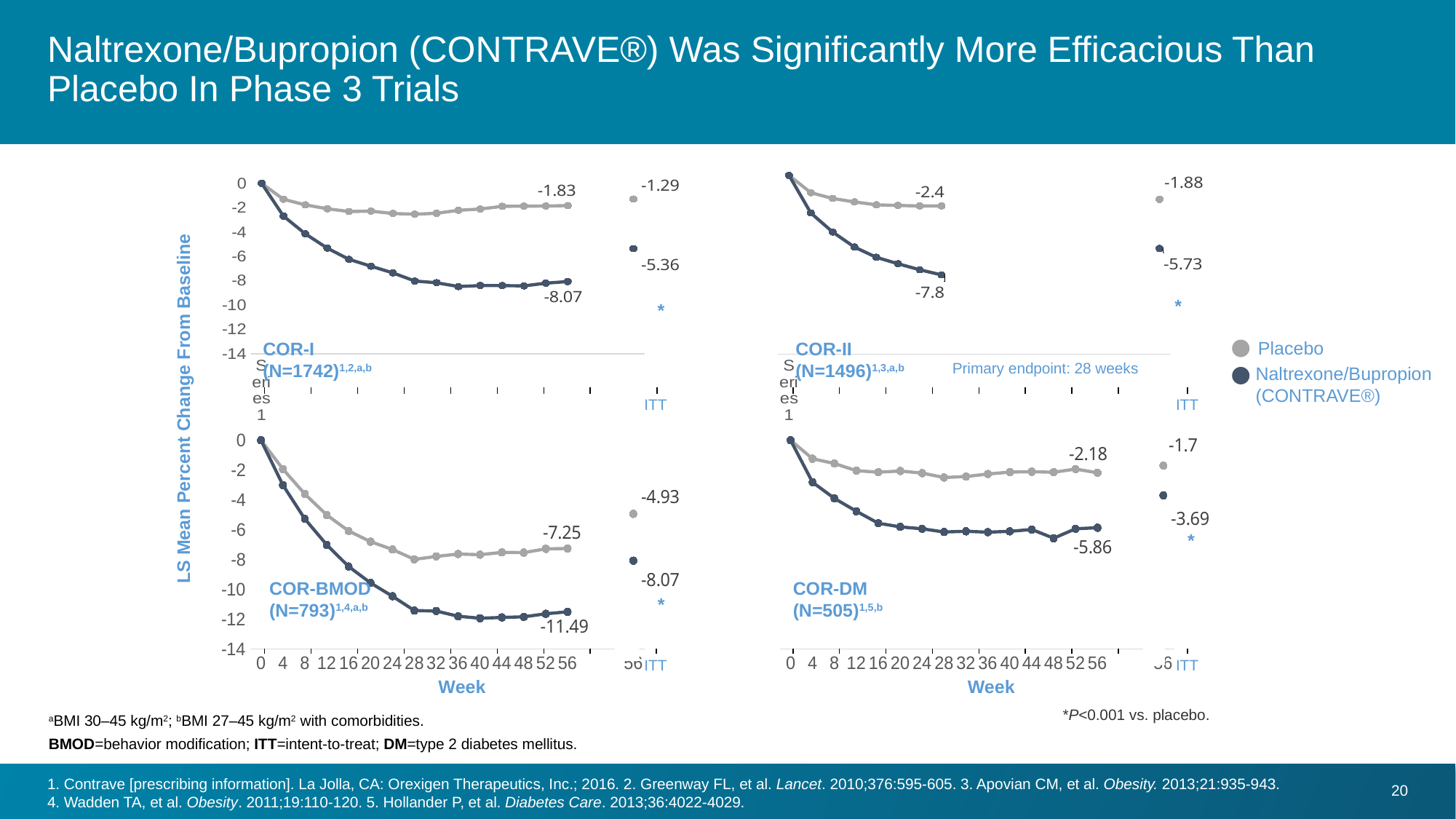
In the COR-I chart, does the Naltrexone/Bupropion (CONTRAVE) line rise or fall from week 0 to week 28? Fall How many series does the legend on the slide list? 2 In the COR-BMOD chart, what is the ITT value labeled for the Placebo group? -4.93 In the COR-I chart, what is the week 56 value labeled for the Naltrexone/Bupropion (CONTRAVE) line? -8.07 What kind of chart is used to show the COR-II results? Line chart In the COR-BMOD chart, what is the week 56 value labeled for the Placebo line? -7.25 In the COR-I chart, what is the week 56 value labeled for the Placebo line? -1.83 In the COR-DM chart, what is the difference between the week 56 Placebo value (-2.18) and the Naltrexone/Bupropion value (-5.86)? 3.68 In the COR-BMOD chart, which line shows the larger percent weight loss at week 56, Placebo or Naltrexone/Bupropion (CONTRAVE)? Naltrexone/Bupropion (CONTRAVE) In the COR-DM chart, what is the ITT value labeled for the Naltrexone/Bupropion (CONTRAVE) group? -3.69 In the COR-I chart, what is the difference between the week 56 Placebo value (-1.83) and the Naltrexone/Bupropion value (-8.07)? 6.24